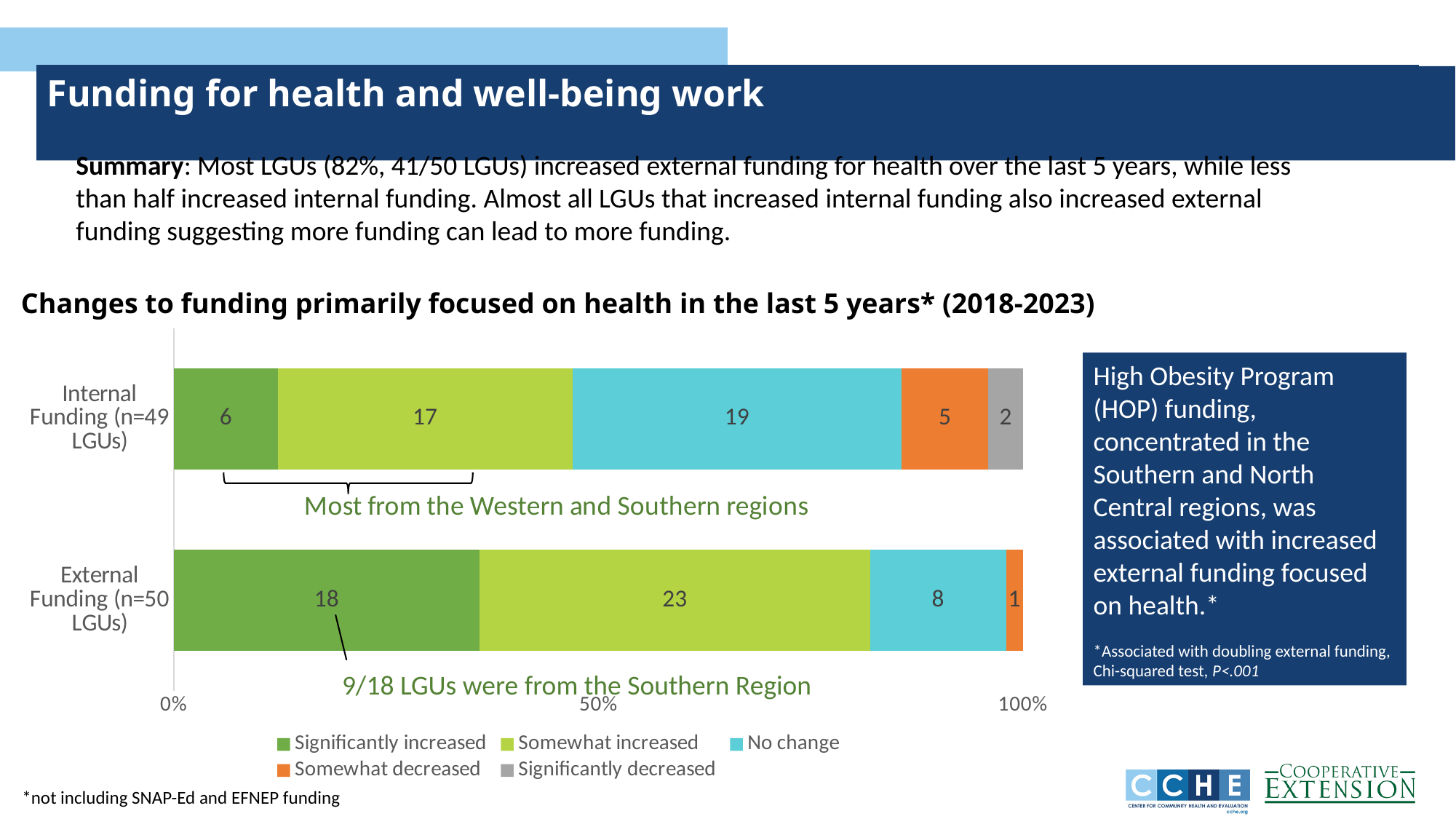
What is the difference between the 'Significantly increased' values for External Funding and Internal Funding? 12 Which response category has the highest value for Internal Funding (n=49 LGUs)? No change How many funding categories are plotted on the chart? 2 What is the value for 'Significantly increased' for External Funding (n=50 LGUs)? 18 How many series does the legend list? 5 Which is larger: the 'Somewhat increased' value for Internal Funding or for External Funding? External Funding What is the value for 'Somewhat increased' for Internal Funding (n=49 LGUs)? 17 What is the title of the chart? Changes to funding primarily focused on health in the last 5 years* (2018-2023) What is the value for 'Significantly decreased' for Internal Funding (n=49 LGUs)? 2 What is the value for 'No change' for External Funding (n=50 LGUs)? 8 What kind of chart is shown on the slide? Stacked bar chart